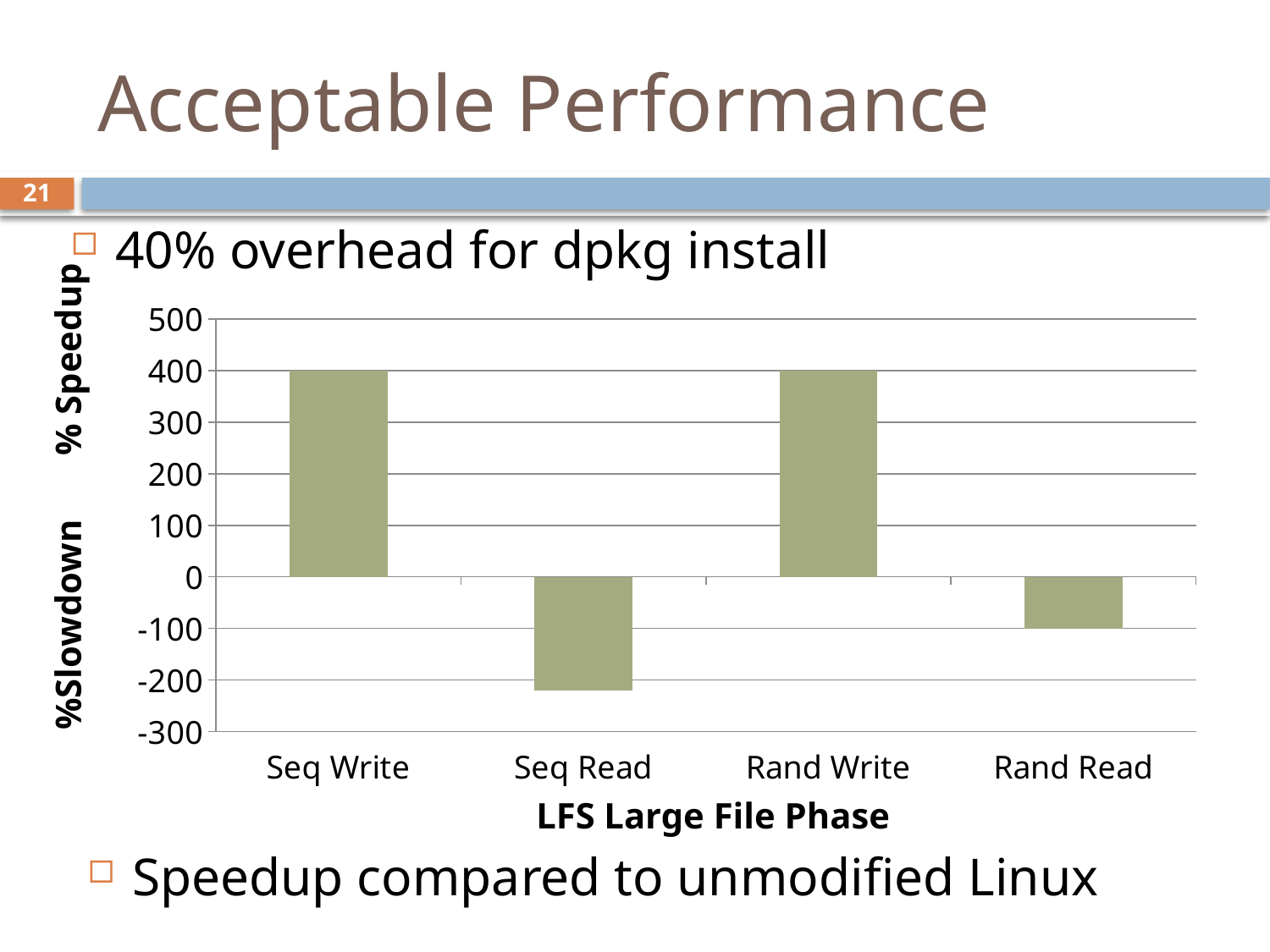
Which is larger, the value for Rand Read or the value for Seq Read? Rand Read What is the title of the x axis of the chart? LFS Large File Phase Which is larger, the value for Seq Write or the value for Seq Read? Seq Write How many categories are shown on the x axis of the chart? 4 Is the value for Seq Write greater or less than 300? greater What is the value for Rand Write? 400 Which category has the lowest value in the chart? Seq Read What kind of chart is shown on the slide? bar chart What is the value for Rand Read? -100 Is the value for Seq Read greater or less than -200? less What is the value for Seq Write? 400 What is the label on the y axis of the chart? %Slowdown % Speedup